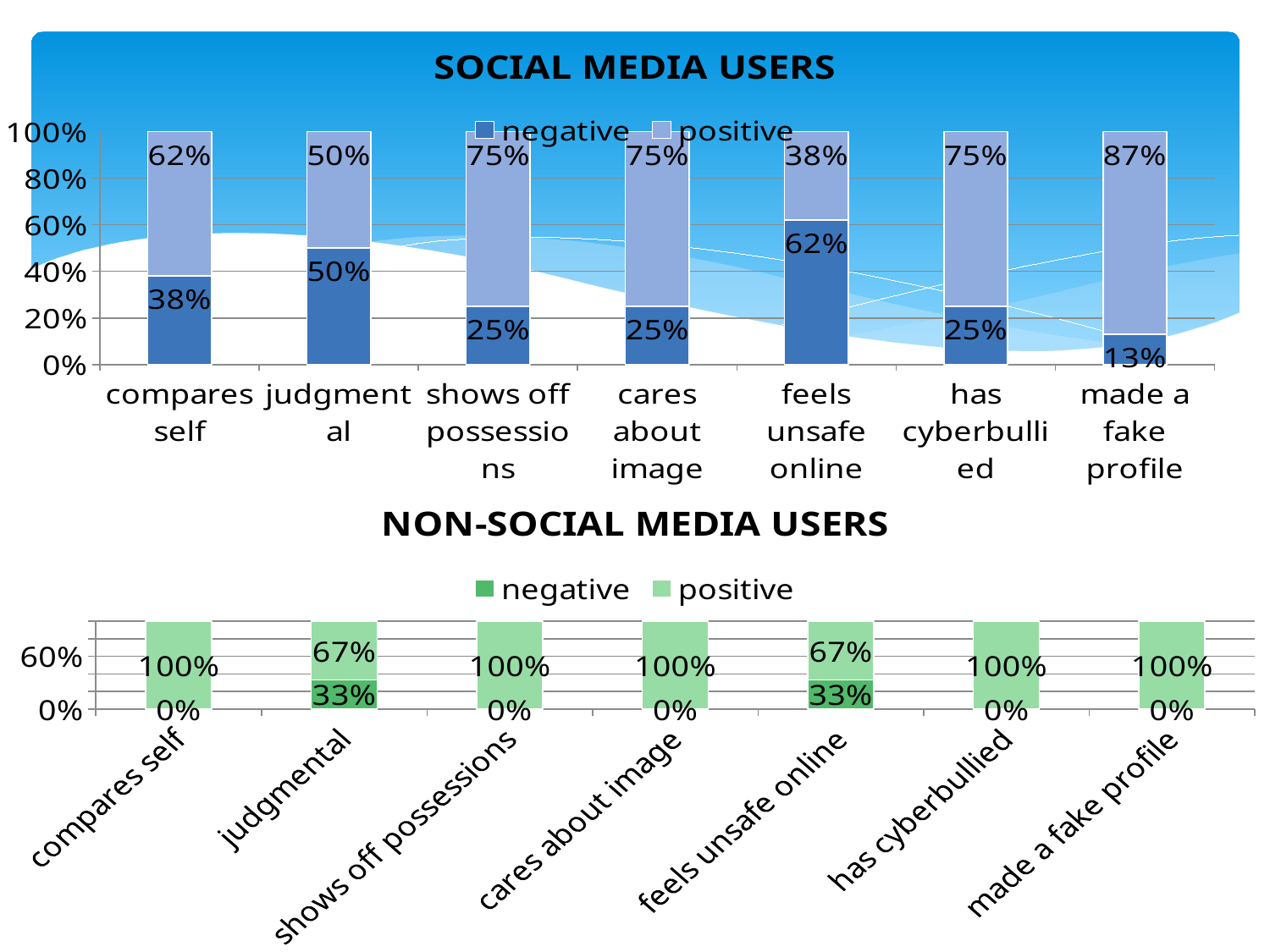
In the SOCIAL MEDIA USERS chart, what is the negative value for 'feels unsafe online'? 62% In the SOCIAL MEDIA USERS chart, what is the difference between the positive and negative values for 'compares self'? 24% In the NON-SOCIAL MEDIA USERS chart, what is the negative value for 'judgmental'? 33% In the SOCIAL MEDIA USERS chart, which category has the lowest negative value? made a fake profile In the NON-SOCIAL MEDIA USERS chart, what is the positive value for 'has cyberbullied'? 100% How many series does the legend of the NON-SOCIAL MEDIA USERS chart list? 2 In the SOCIAL MEDIA USERS chart, which category has the highest negative value? feels unsafe online In the NON-SOCIAL MEDIA USERS chart, what is the total of the stacked bar for 'feels unsafe online'? 100% What kind of chart is the NON-SOCIAL MEDIA USERS chart? stacked bar chart How many categories are shown on the x axis of the SOCIAL MEDIA USERS chart? 7 In the SOCIAL MEDIA USERS chart, is the negative value for 'compares self' or for 'judgmental' larger? judgmental In the SOCIAL MEDIA USERS chart, what is the positive value for 'made a fake profile'? 87%